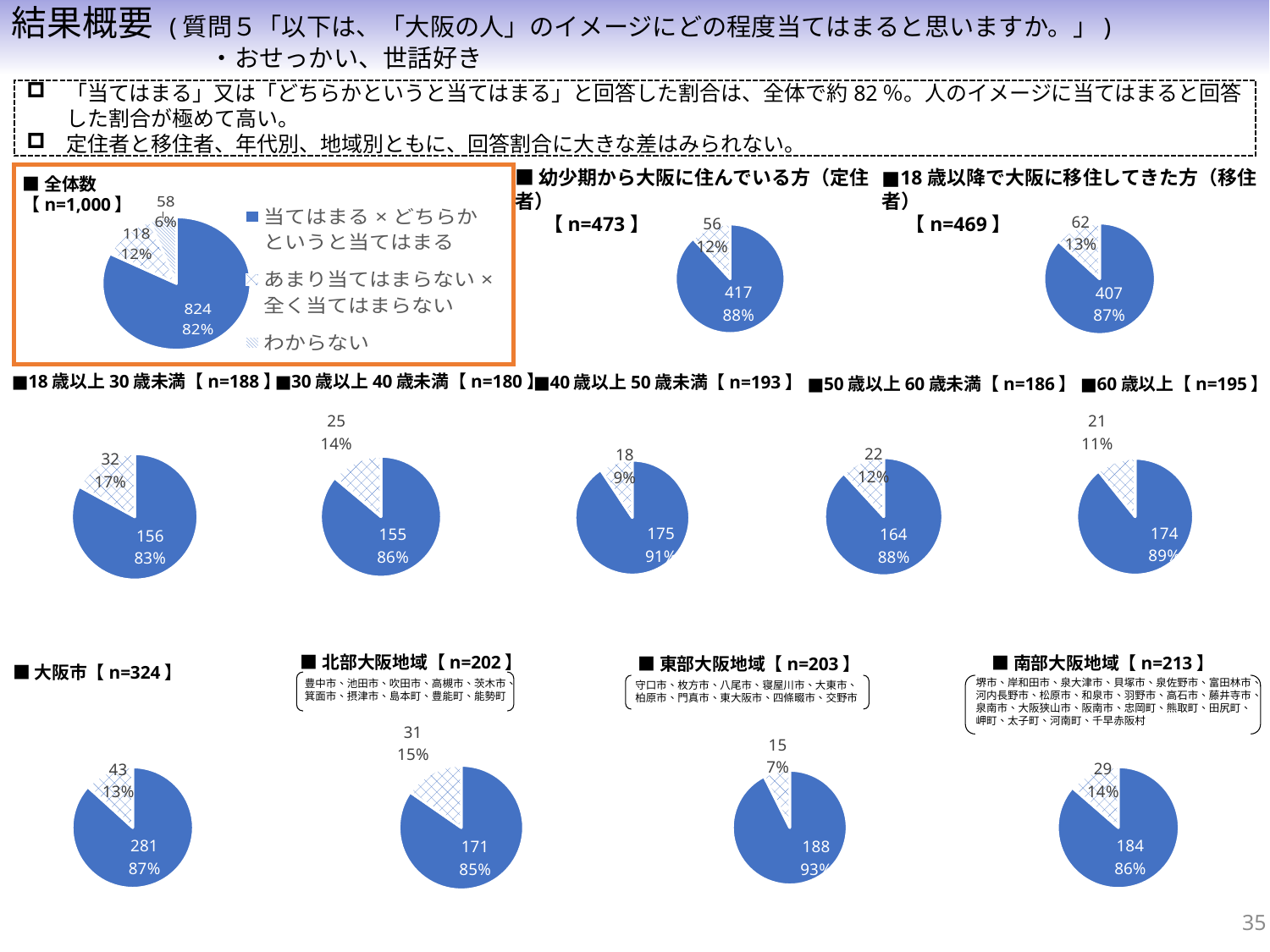
In the 18歳以降で大阪に移住してきた方（移住者）【n=469】 pie chart, what value is shown for the smaller slice? 62 What is the difference between the largest-slice value in the 東部大阪地域【n=203】 pie chart and the largest-slice value in the 南部大阪地域【n=213】 pie chart? 4 Which pie chart among the age-group charts (18歳以上30歳未満, 30歳以上40歳未満, 40歳以上50歳未満, 50歳以上60歳未満, 60歳以上) shows the highest percentage for the largest slice? 40歳以上50歳未満【n=193】 In the 大阪市【n=324】 pie chart, what value is shown for the largest slice? 281 Which pie chart among the regional charts (大阪市, 北部大阪地域, 東部大阪地域, 南部大阪地域) shows the lowest percentage for the largest slice? 北部大阪地域【n=202】 Which is larger: the largest-slice percentage in the 18歳以上30歳未満【n=188】 pie chart or in the 60歳以上【n=195】 pie chart? 60歳以上【n=195】 In the 全体数【n=1,000】 pie chart, what percentage is shown for the わからない slice? 6% In the 40歳以上50歳未満【n=193】 pie chart, what percentage is shown for the smaller slice? 9% In the 全体数【n=1,000】 pie chart, what is the value shown for the largest slice? 824 What type of chart is used for the 全体数【n=1,000】 data? Pie chart How many entries does the legend of the 全体数【n=1,000】 pie chart list? 3 In the 幼少期から大阪に住んでいる方（定住者）【n=473】 pie chart, what percentage is shown for the largest slice? 88%